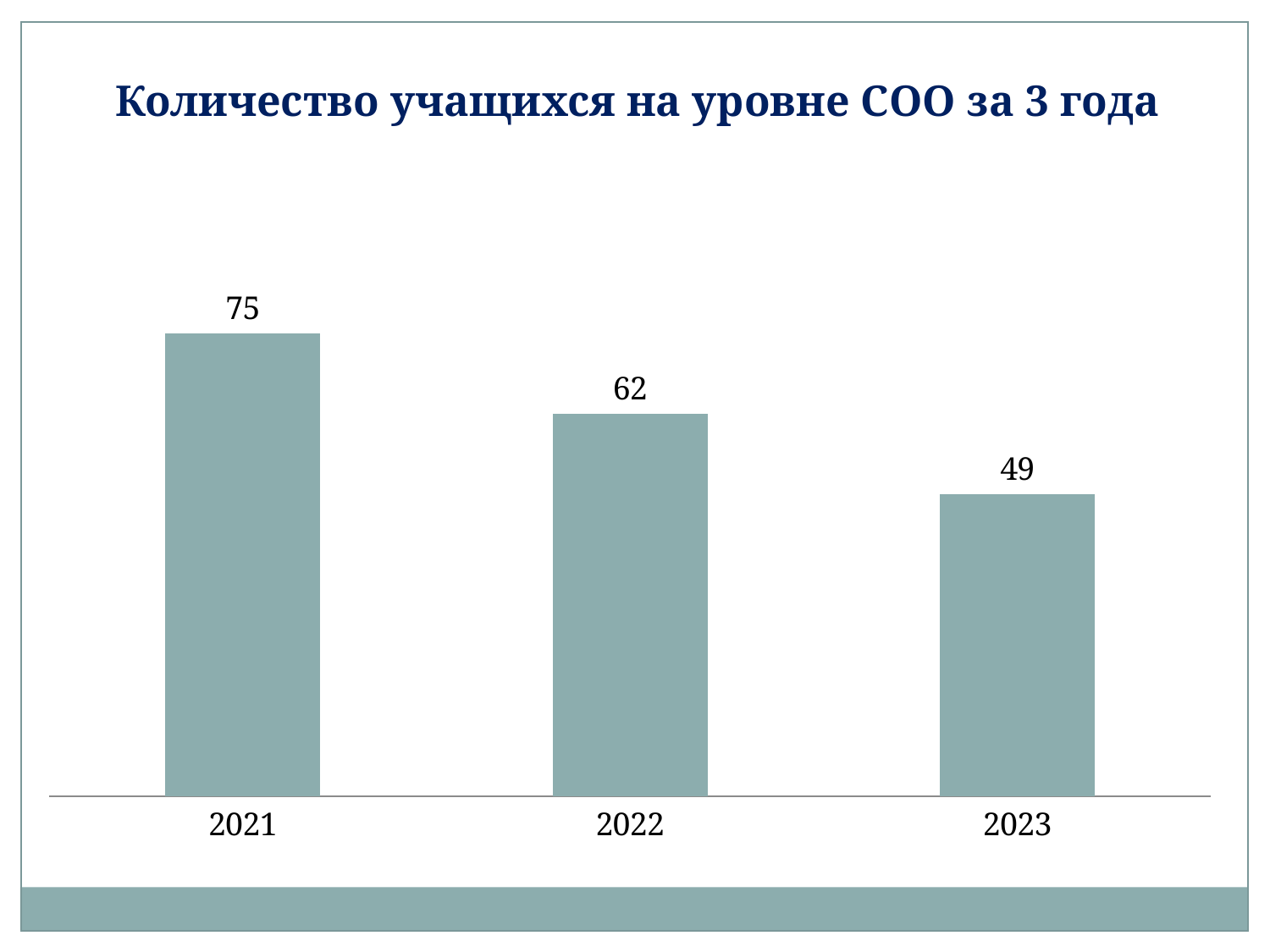
What kind of chart is this? bar chart Which is larger, the value for 2022 or the value for 2023? 2022 Which year has the lowest value? 2023 Do the values rise or fall from 2021 to 2023? fall What is the difference between the values for 2021 and 2022? 13 What is the value for 2021? 75 What is the value for 2022? 62 What is the difference between the values for 2021 and 2023? 26 How many years are shown on the chart? 3 What is the value for 2023? 49 Which year has the highest value? 2021 What is the title of the chart? Количество учащихся на уровне СОО за 3 года